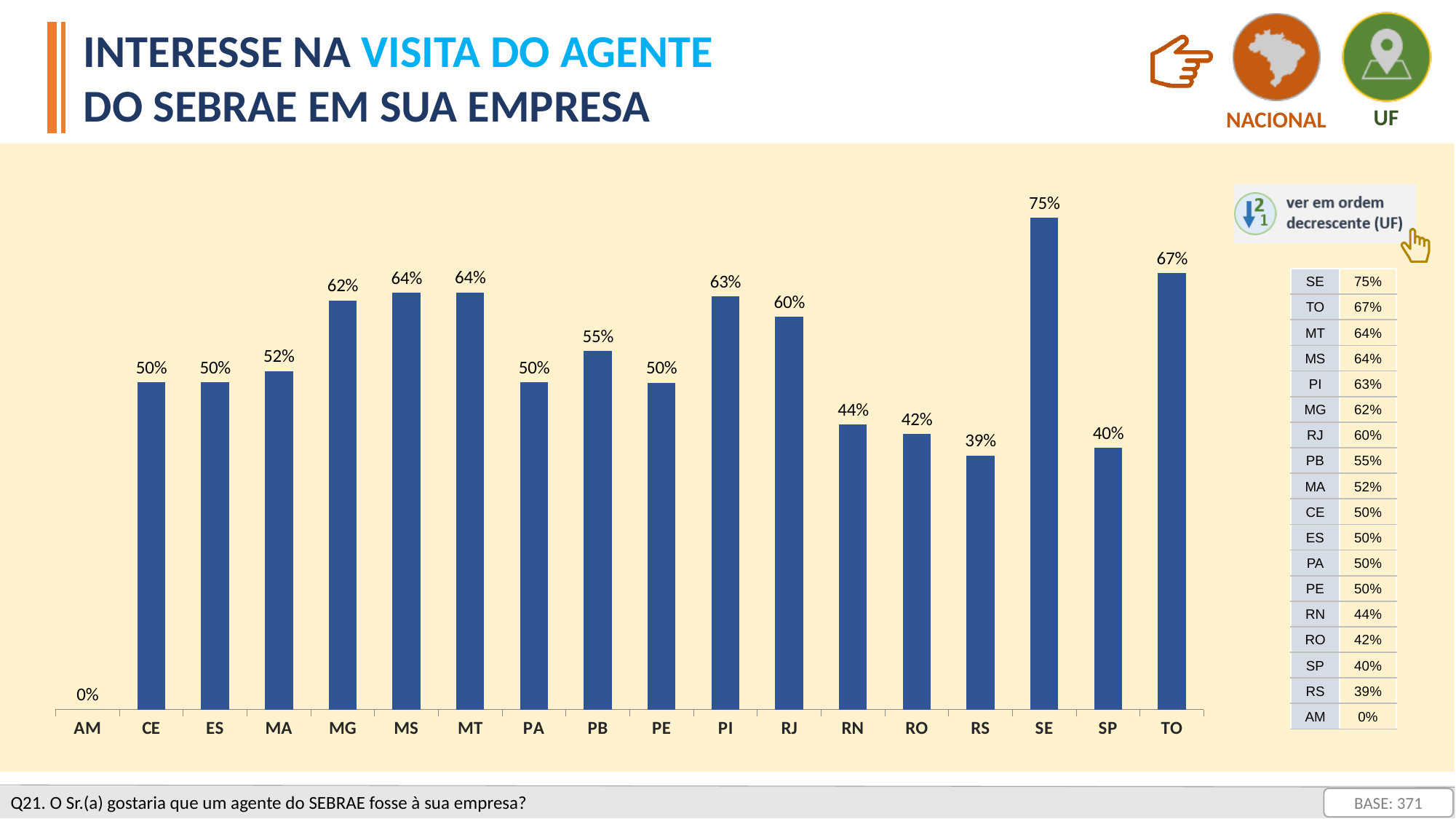
What is the value for SE? 75% How many states are shown on the x axis? 18 What is the difference between the values for SE and TO? 8% How many states have a value of exactly 50%? 4 What is the value for RS? 39% What kind of chart is shown? bar chart Which is larger, the value for SP or the value for RO? RO Which state has the lowest value? AM What is the value for PB? 55% Which is larger, the value for RJ or the value for PI? PI Which state has the highest value? SE What is the difference between the values for MG and RN? 18%